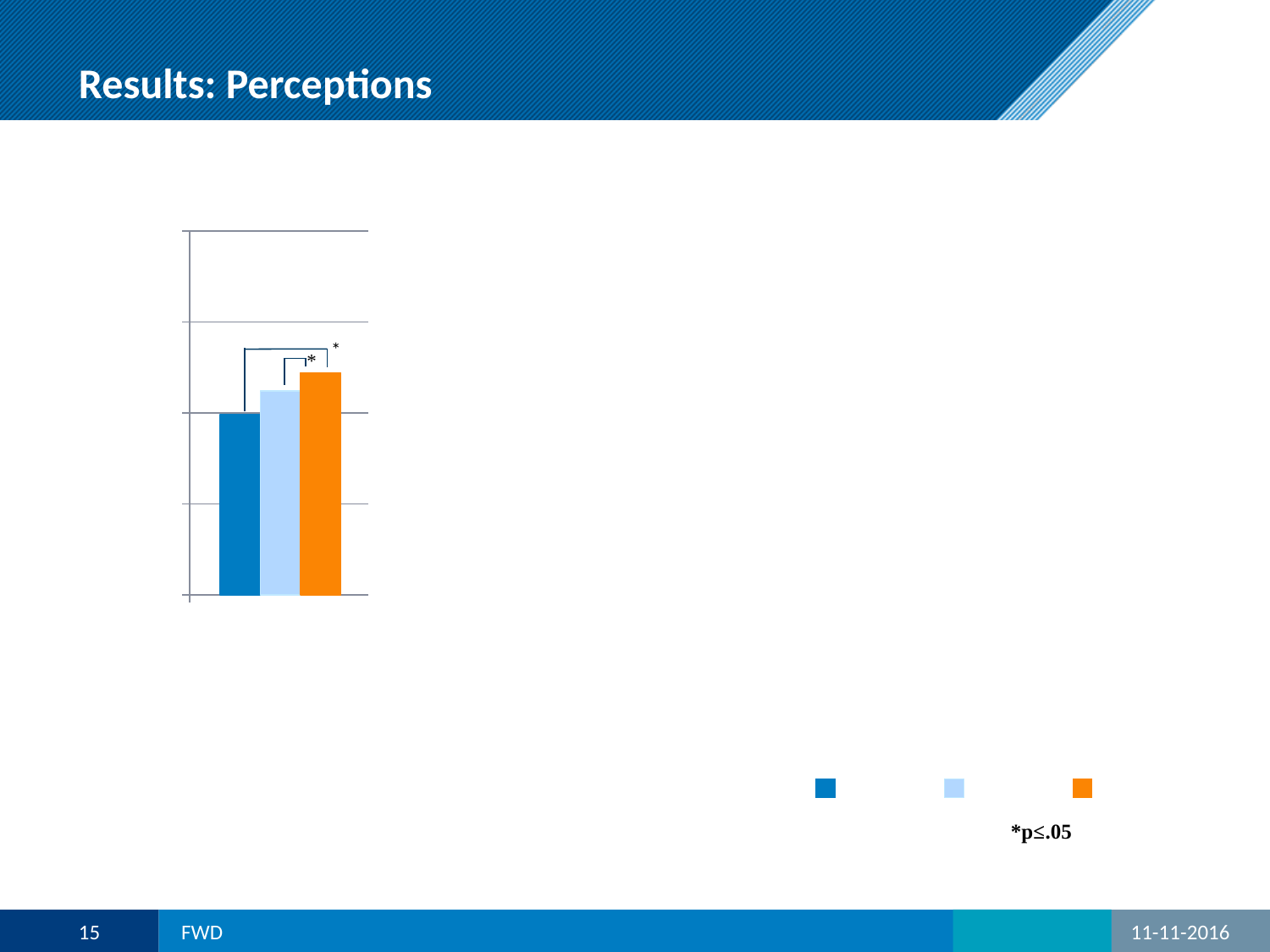
What colour is the bar on the far right of the chart? orange Do the bar heights rise or fall from left to right across the chart? rise How many bars are plotted in the chart? 3 Is the orange bar taller or shorter than the dark blue bar? taller Which bar is the tallest in the chart: the dark blue, the light blue, or the orange bar? the orange bar How many entries does the chart's legend show? 3 Which bar is the shortest in the chart: the dark blue, the light blue, or the orange bar? the dark blue bar What kind of chart is shown on the slide? bar chart Is the light blue bar taller or shorter than the orange bar? shorter What significance level does the note below the legend give for the asterisks? *p≤.05